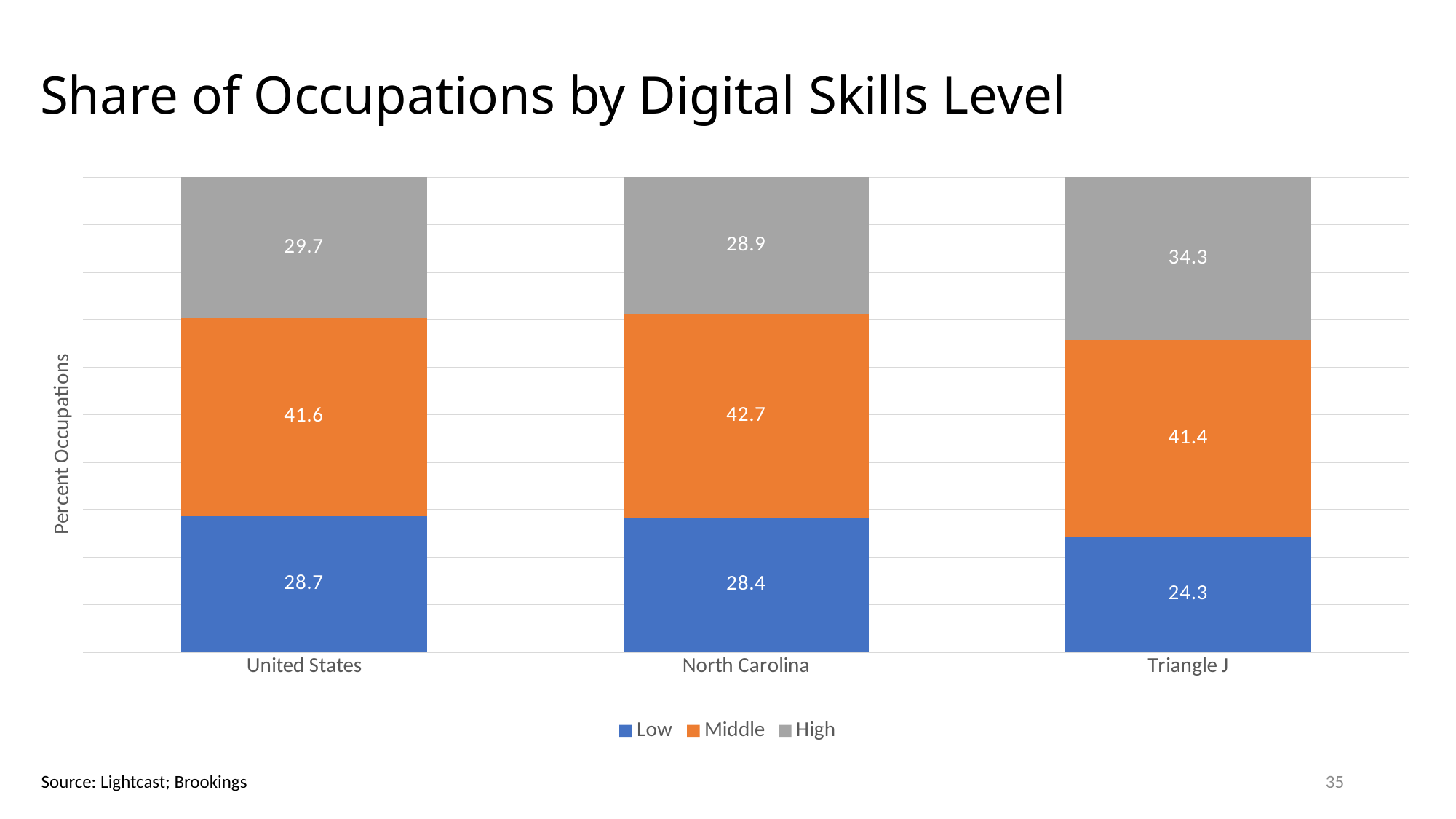
How many regions are shown on the x axis? 3 Which is larger: the Middle share for North Carolina or the Middle share for the United States? North Carolina Which region has the highest High digital skills share? Triangle J What is the High digital skills share for the United States? 29.7 Which region has the lowest Low digital skills share? Triangle J What kind of chart is shown on the slide? Stacked bar chart What is the title of the chart? Share of Occupations by Digital Skills Level How many series does the legend list? 3 What is the total of the stacked bar for the United States? 100.0 What is the Low digital skills share for Triangle J? 24.3 What is the difference between the High share for Triangle J and the High share for North Carolina? 5.4 What is the Middle digital skills share for North Carolina? 42.7